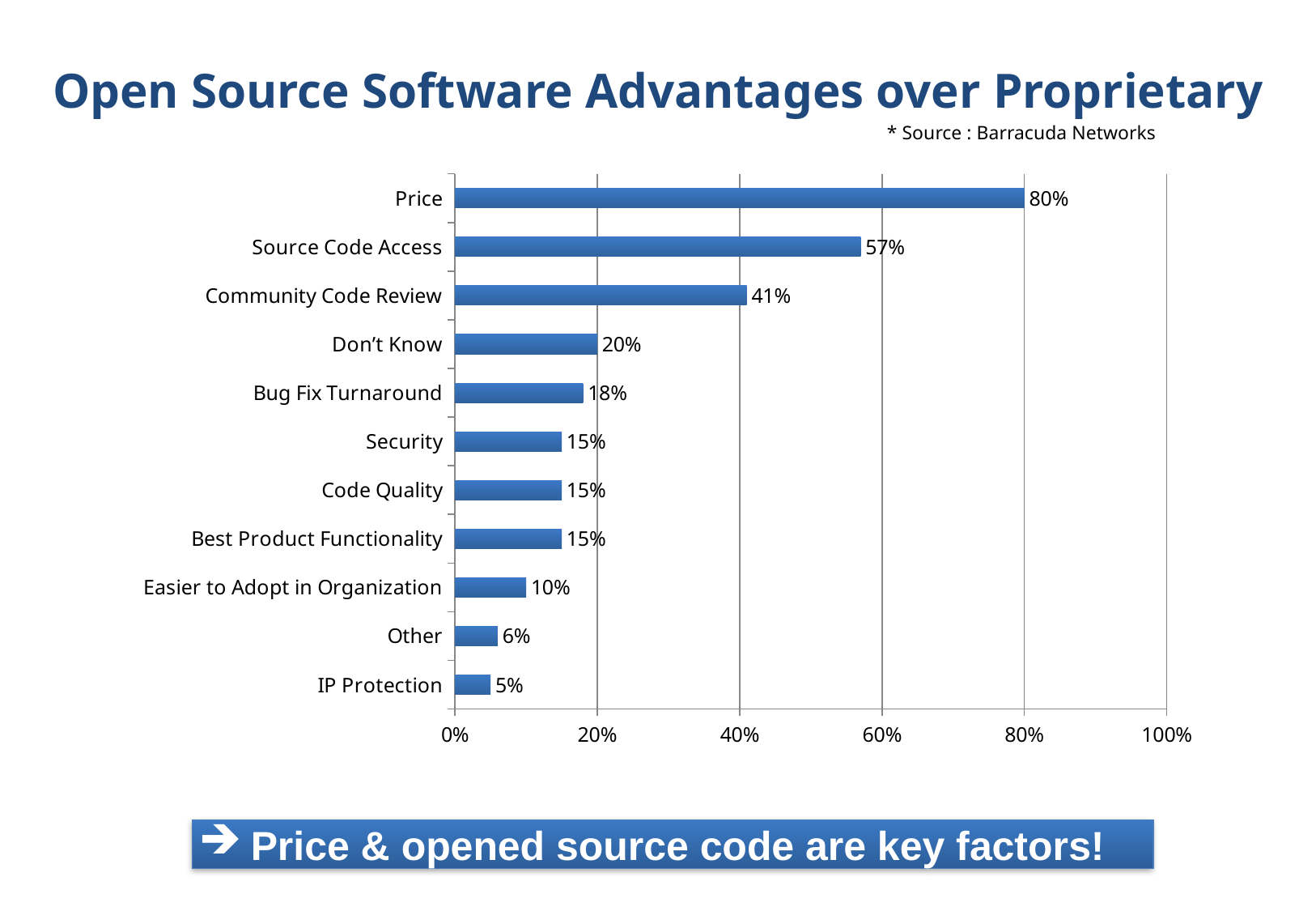
What is the value for IP Protection? 5% Which category has the lowest value? IP Protection What kind of chart is shown on the slide? Bar chart What is the value for Price? 80% What is the value for Bug Fix Turnaround? 18% What is the difference between the values for Price and Source Code Access? 23% What is the difference between the values for Community Code Review and Don't Know? 21% What is the value for Source Code Access? 57% Which category has the highest value? Price Which is larger, the value for Easier to Adopt in Organization or the value for Other? Easier to Adopt in Organization What is the source cited for the chart? Barracuda Networks How many categories are shown in the chart? 11